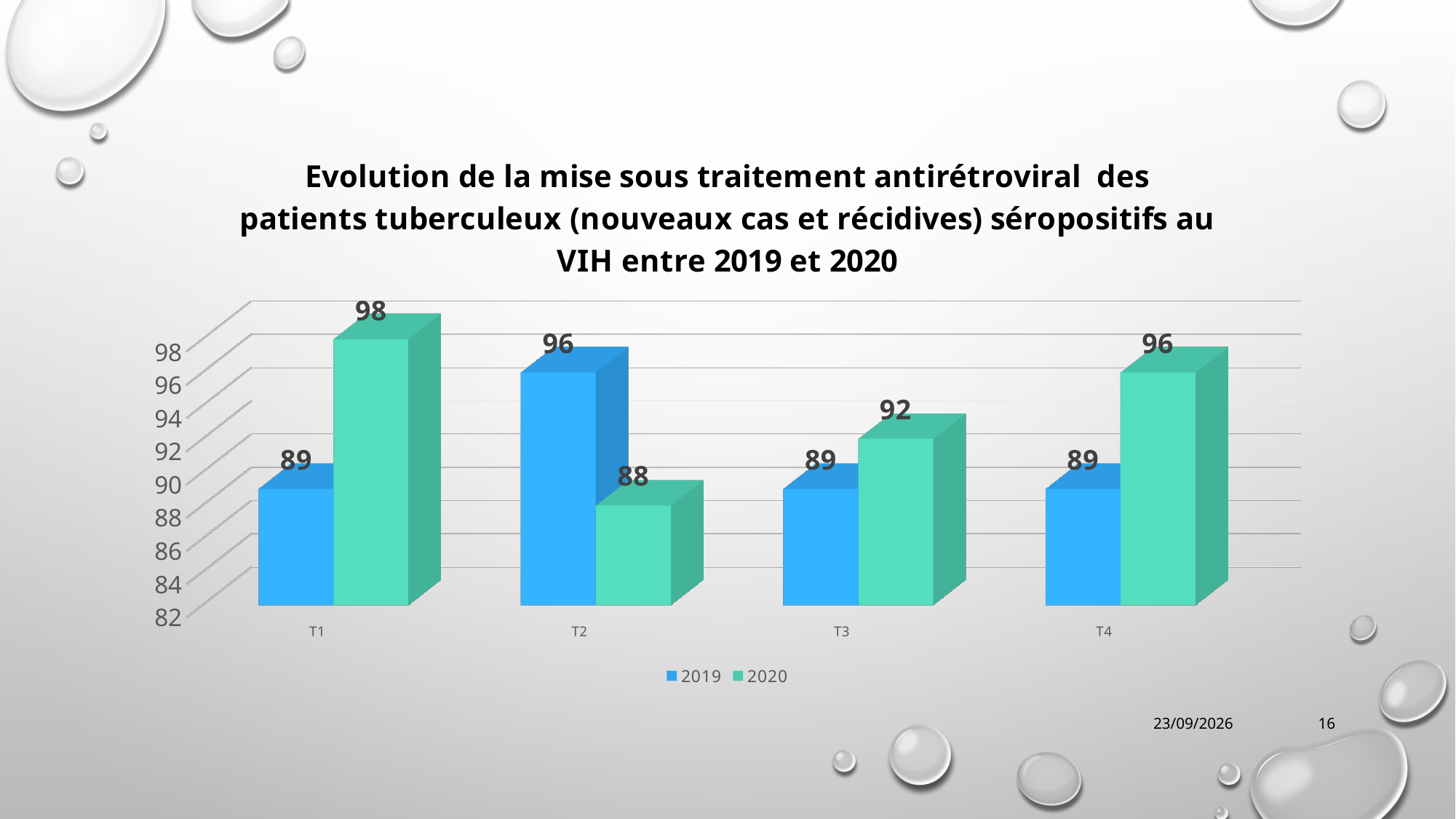
What kind of chart is shown on the slide? Bar chart Which is larger at T2, the 2019 value or the 2020 value? 2019 Which quarter has the highest value for the 2019 series? T2 What is the value for 2020 at T2? 88 Which quarter has the highest value for the 2020 series? T1 What is the value for 2019 at T1? 89 What is the value for 2020 at T3? 92 How many series does the legend list? 2 How many quarters are shown on the x axis? 4 Which quarter has the lowest value for the 2020 series? T2 What is the value for 2019 at T4? 89 What is the difference between the 2020 and 2019 values at T1? 9